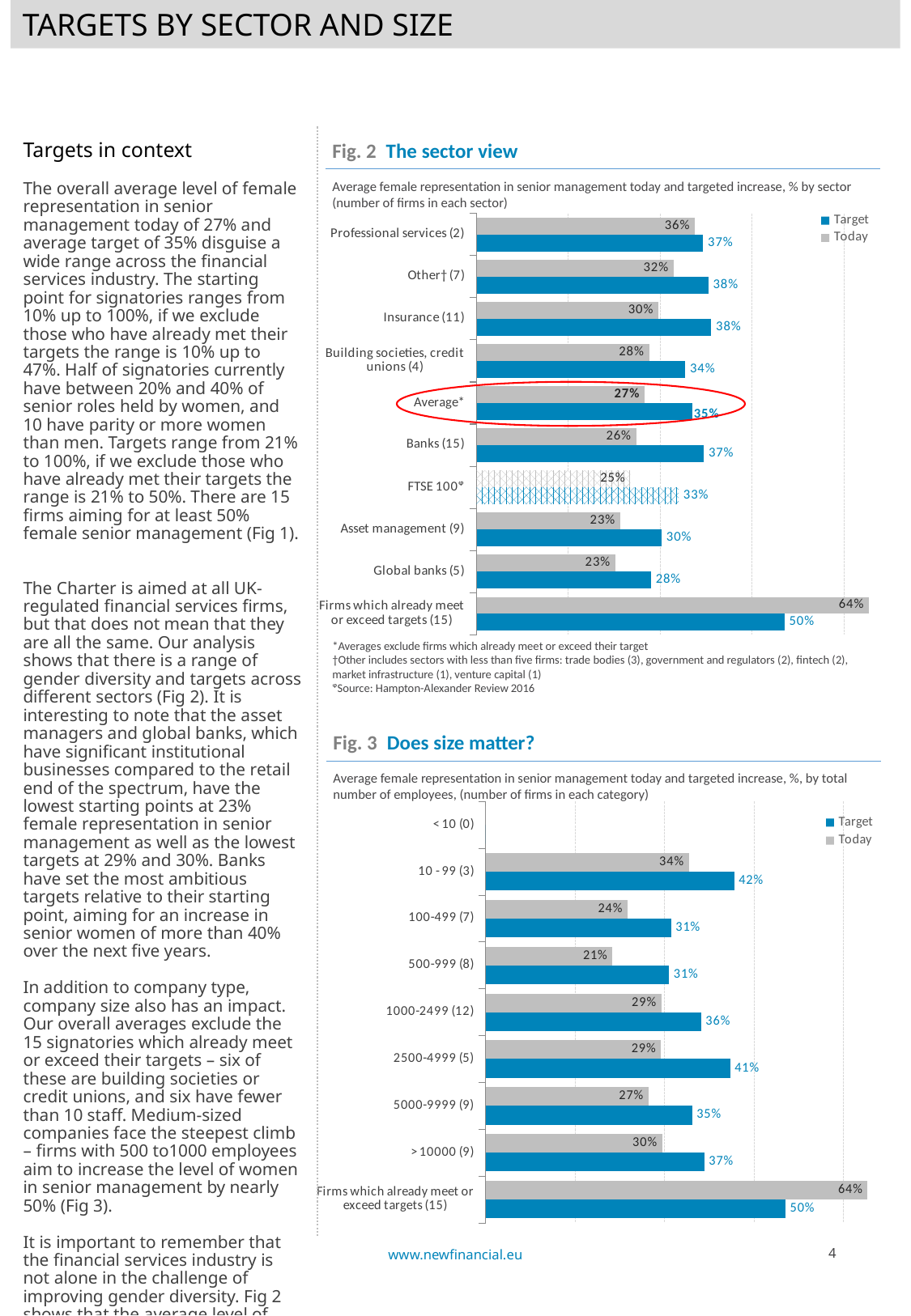
In Fig. 2 The sector view, what is the difference between the Target and Today values for Banks (15)? 11% In Fig. 2 The sector view, what is the Today value for Insurance (11)? 30% In Fig. 2 The sector view, how many series does the legend list? 2 In Fig. 3 Does size matter?, which size category has the lowest Today value? 500-999 (8) In Fig. 2 The sector view, which category has the highest Today value? Firms which already meet or exceed targets (15) In Fig. 2 The sector view, what is the Target value for Banks (15)? 37% In Fig. 2 The sector view, which is larger: the Target value for Asset management (9) or the Target value for Global banks (5)? Asset management (9) In Fig. 3 Does size matter?, what is the difference between the Target and Today values for 10 - 99 (3)? 8% In Fig. 3 Does size matter?, what is the Target value for 2500-4999 (5)? 41% What type of chart is Fig. 3 Does size matter? Bar chart In Fig. 3 Does size matter?, what is the Today value for 500-999 (8)? 21% In Fig. 3 Does size matter?, which colour represents the Target series? Blue